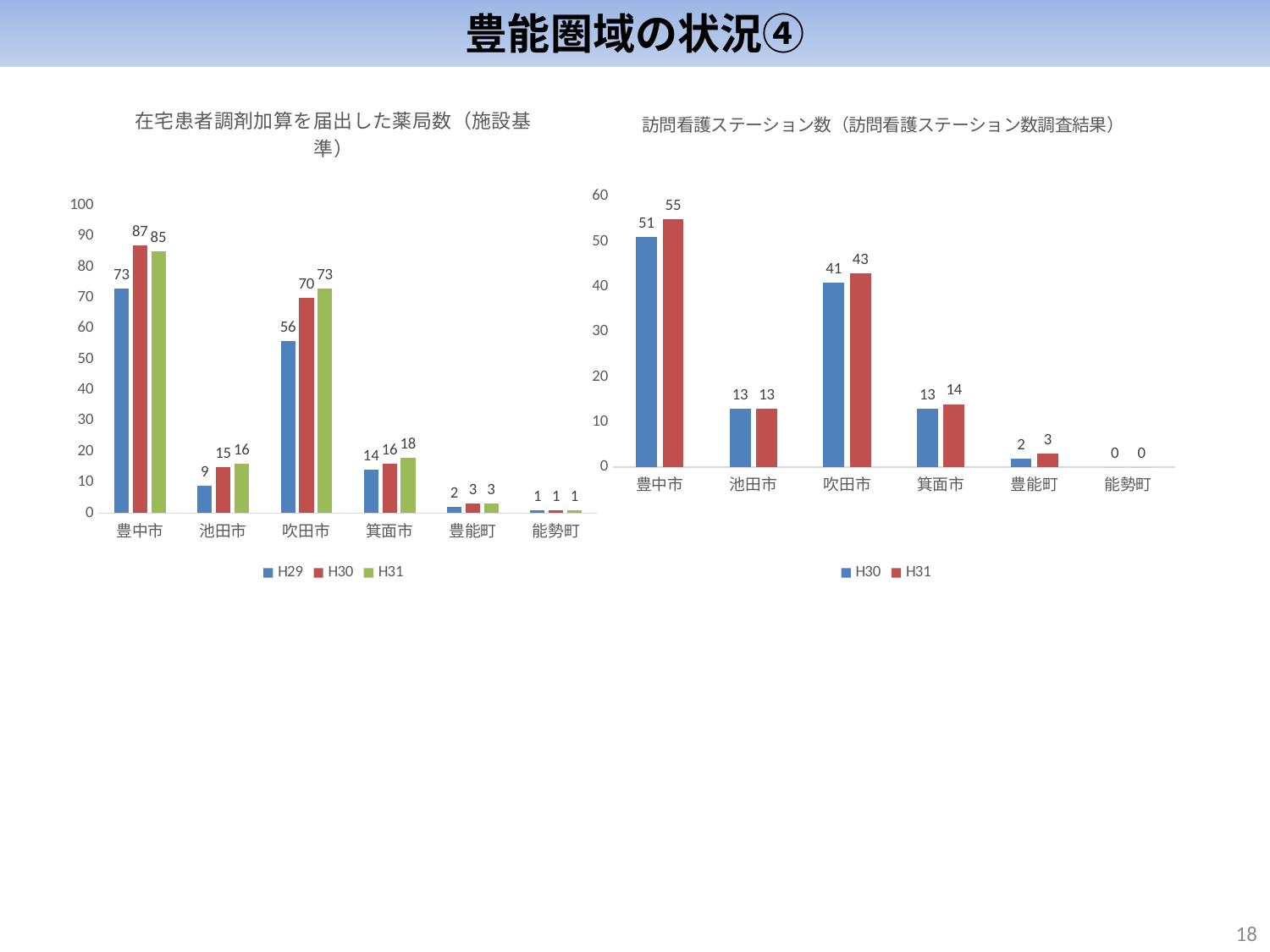
In the left chart (在宅患者調剤加算を届出した薬局数), how many series does the legend list? 3 In the right chart (訪問看護ステーション数), what is the H30 value for 吹田市? 41 In the left chart (在宅患者調剤加算を届出した薬局数), do the values for 箕面市 rise or fall from H29 to H31? rise In the right chart (訪問看護ステーション数), what is the H31 value for 豊中市? 55 In the right chart (訪問看護ステーション数), what is the difference between the H31 values for 豊中市 and 吹田市? 12 In the left chart (在宅患者調剤加算を届出した薬局数), what is the difference between the H31 and H29 values for 吹田市? 17 In the right chart (訪問看護ステーション数), how many municipalities are shown on the x axis? 6 In the left chart (在宅患者調剤加算を届出した薬局数), what is the H30 value for 豊中市? 87 What kind of chart is the right chart (訪問看護ステーション数)? bar chart In the right chart (訪問看護ステーション数), which municipality has the lowest H31 value? 能勢町 In the left chart (在宅患者調剤加算を届出した薬局数), which city has the highest H31 value? 豊中市 In the left chart (在宅患者調剤加算を届出した薬局数), what is the H29 value for 吹田市? 56